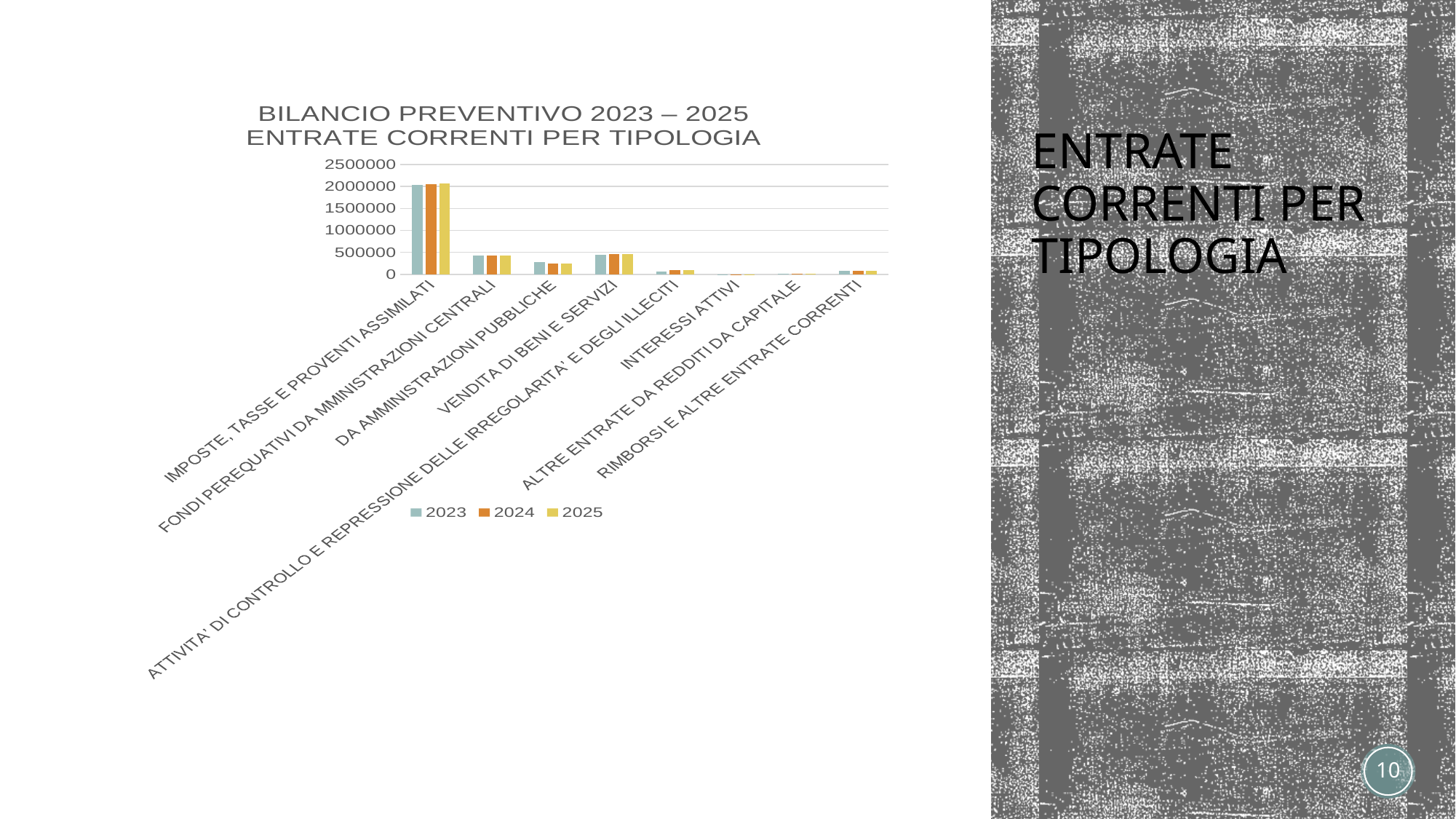
What is the title of the chart? BILANCIO PREVENTIVO 2023 – 2025 ENTRATE CORRENTI PER TIPOLOGIA How many series does the legend list? 3 What type of chart is shown on the slide? bar chart Which is larger in 2024: VENDITA DI BENI E SERVIZI or DA AMMINISTRAZIONI PUBBLICHE? VENDITA DI BENI E SERVIZI How many categories are shown on the x axis of the chart? 8 Which is larger in 2025: DA AMMINISTRAZIONI PUBBLICHE or INTERESSI ATTIVI? DA AMMINISTRAZIONI PUBBLICHE Which category has the highest values in the chart? IMPOSTE, TASSE E PROVENTI ASSIMILATI Is the 2023 value for IMPOSTE, TASSE E PROVENTI ASSIMILATI greater or less than 1500000? greater Is the 2024 value for FONDI PEREQUATIVI DA AMMINISTRAZIONI CENTRALI greater or less than 500000? less Which is larger in 2023: IMPOSTE, TASSE E PROVENTI ASSIMILATI or FONDI PEREQUATIVI DA AMMINISTRAZIONI CENTRALI? IMPOSTE, TASSE E PROVENTI ASSIMILATI Is the 2025 value for VENDITA DI BENI E SERVIZI greater or less than 1000000? less Which series is shown in orange in the legend? 2024